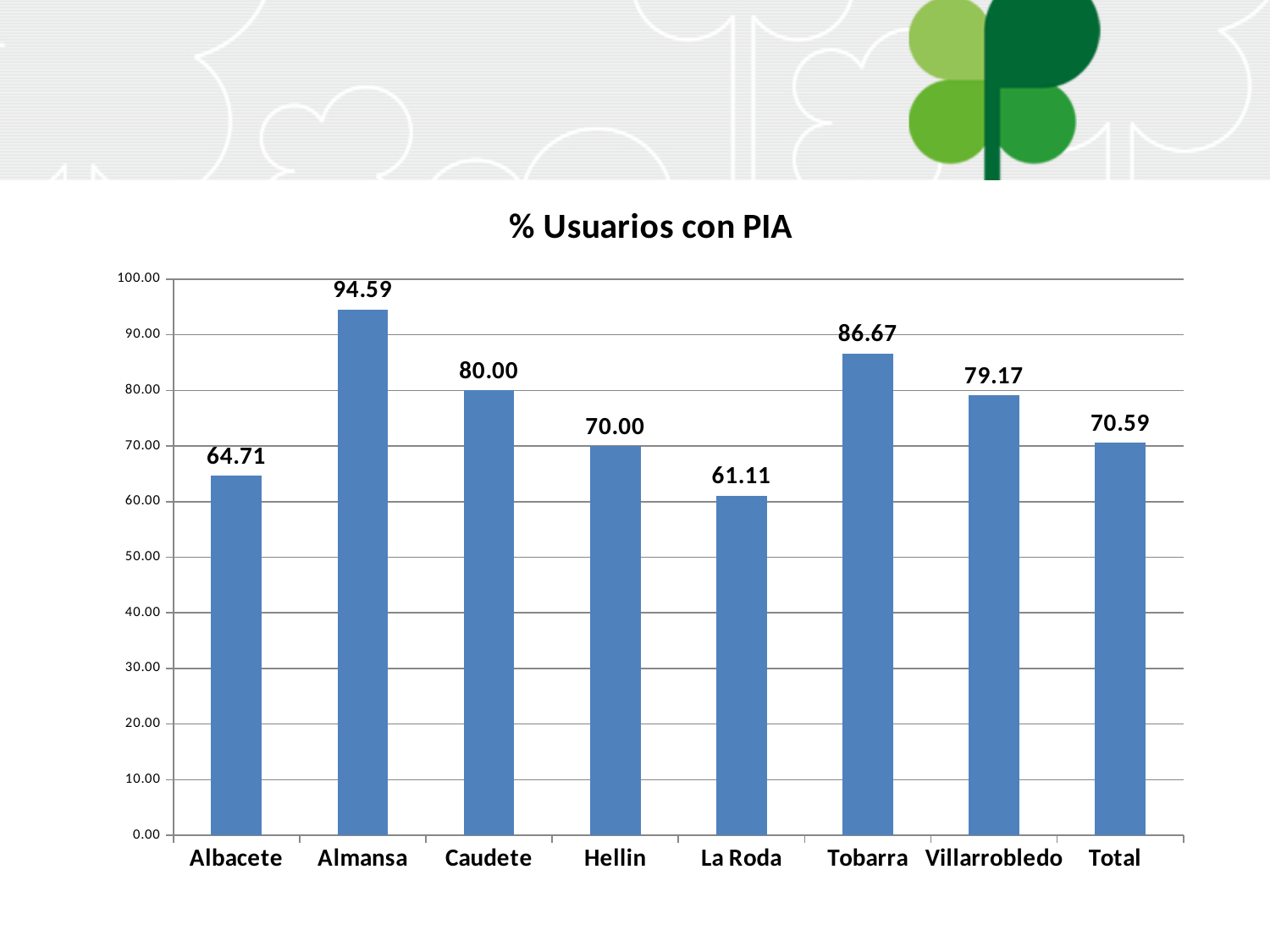
What is the difference between the values for Tobarra and Hellin? 16.67 What is the title of the chart? % Usuarios con PIA Which category has the highest value? Almansa What is the value for Total? 70.59 What kind of chart is shown on the slide? bar chart How many categories are shown on the x axis? 8 Is the value for Albacete greater or less than 70.00? less What is the value for Almansa? 94.59 What is the value for Villarrobledo? 79.17 Which category has the lowest value? La Roda What is the value for La Roda? 61.11 Which is larger, the value for Caudete or the value for Villarrobledo? Caudete